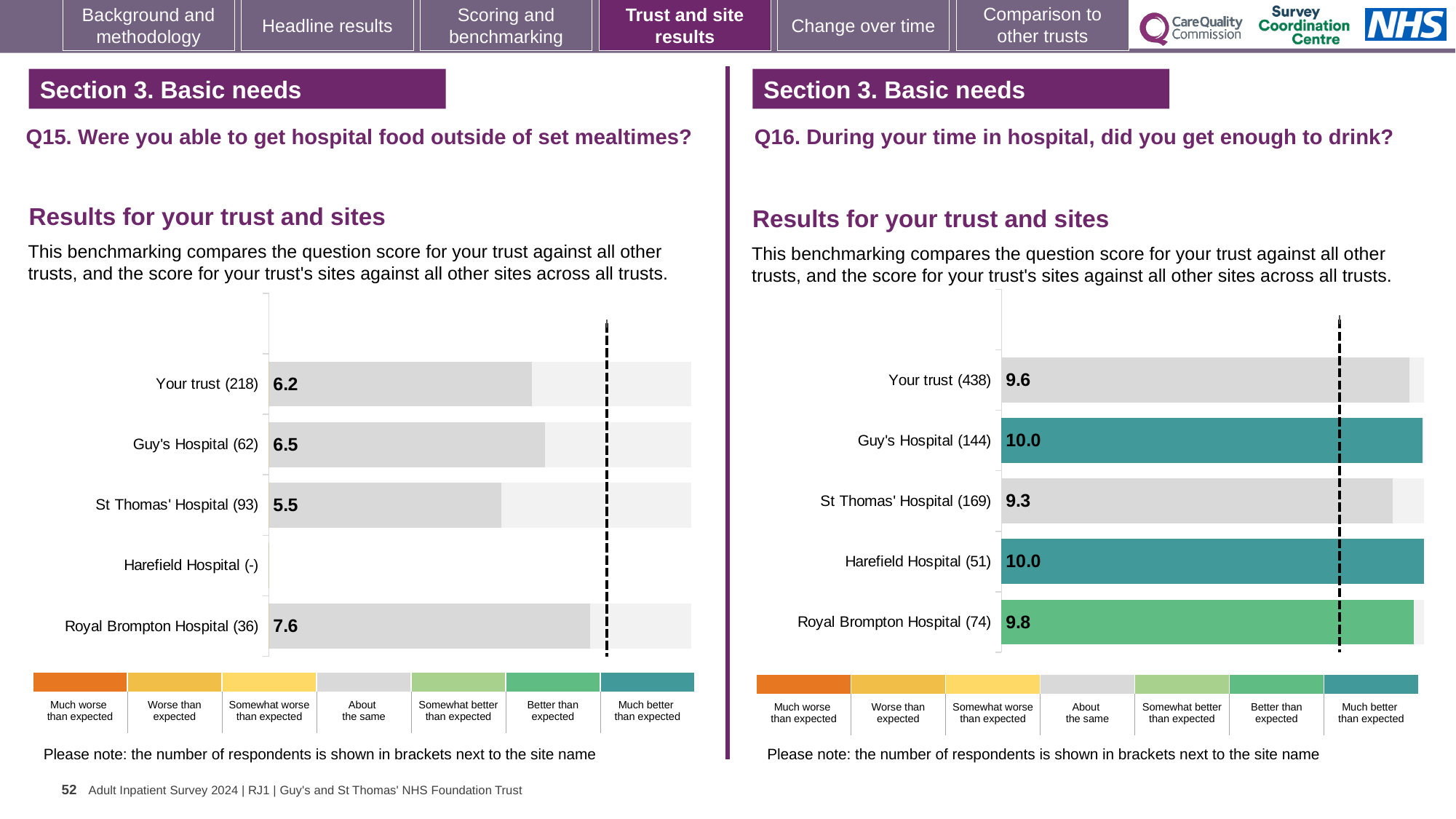
On the Q16 chart, which site has the lowest score? St Thomas' Hospital On the Q15 chart, what is the difference between the scores for Guy's Hospital and St Thomas' Hospital? 1.0 On the Q16 chart, which has the larger score, Your trust or Royal Brompton Hospital? Royal Brompton Hospital On the Q16 chart, what is the score for Royal Brompton Hospital (74)? 9.8 On the Q15 chart, which site has the highest score? Royal Brompton Hospital How many sites (including Your trust) are listed on the Q15 chart? 5 On the Q16 chart, what is the score for St Thomas' Hospital (169)? 9.3 What type of chart is used on the Q16 slide? Bar chart On the Q16 chart, what is the difference between the scores for Guy's Hospital and Your trust? 0.4 On the Q15 chart, what is the score for Your trust (218)? 6.2 On the Q15 chart, which site with a score shown has the lowest score? St Thomas' Hospital On the Q15 chart, what is the score for Royal Brompton Hospital (36)? 7.6